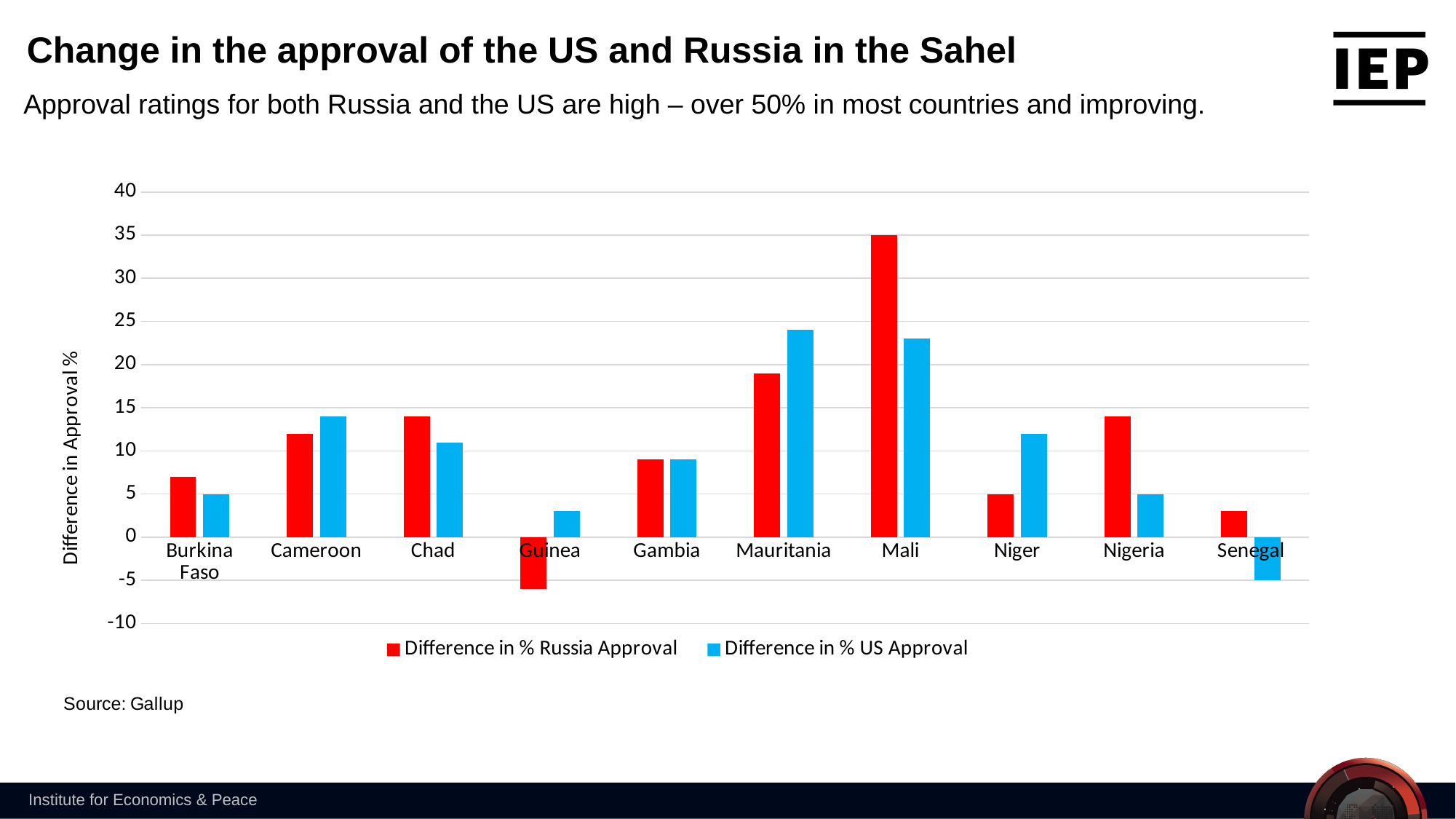
How many series does the chart's legend list? 2 What is the title of the chart on the slide? Change in the approval of the US and Russia in the Sahel Which country has the highest Difference in % Russia Approval? Mali What is the Difference in % US Approval for Senegal? -5 Which country has the lowest Difference in % US Approval? Senegal What is the Difference in % Russia Approval for Mali? 35 What type of chart is shown on the slide? Bar chart For Nigeria, which is larger: the Difference in % Russia Approval or the Difference in % US Approval? Difference in % Russia Approval Is the Difference in % US Approval for Mauritania greater or less than 20? greater How many countries are shown on the x axis of the chart? 10 Which country has the lowest Difference in % Russia Approval? Guinea What is the Difference in % Russia Approval for Niger? 5